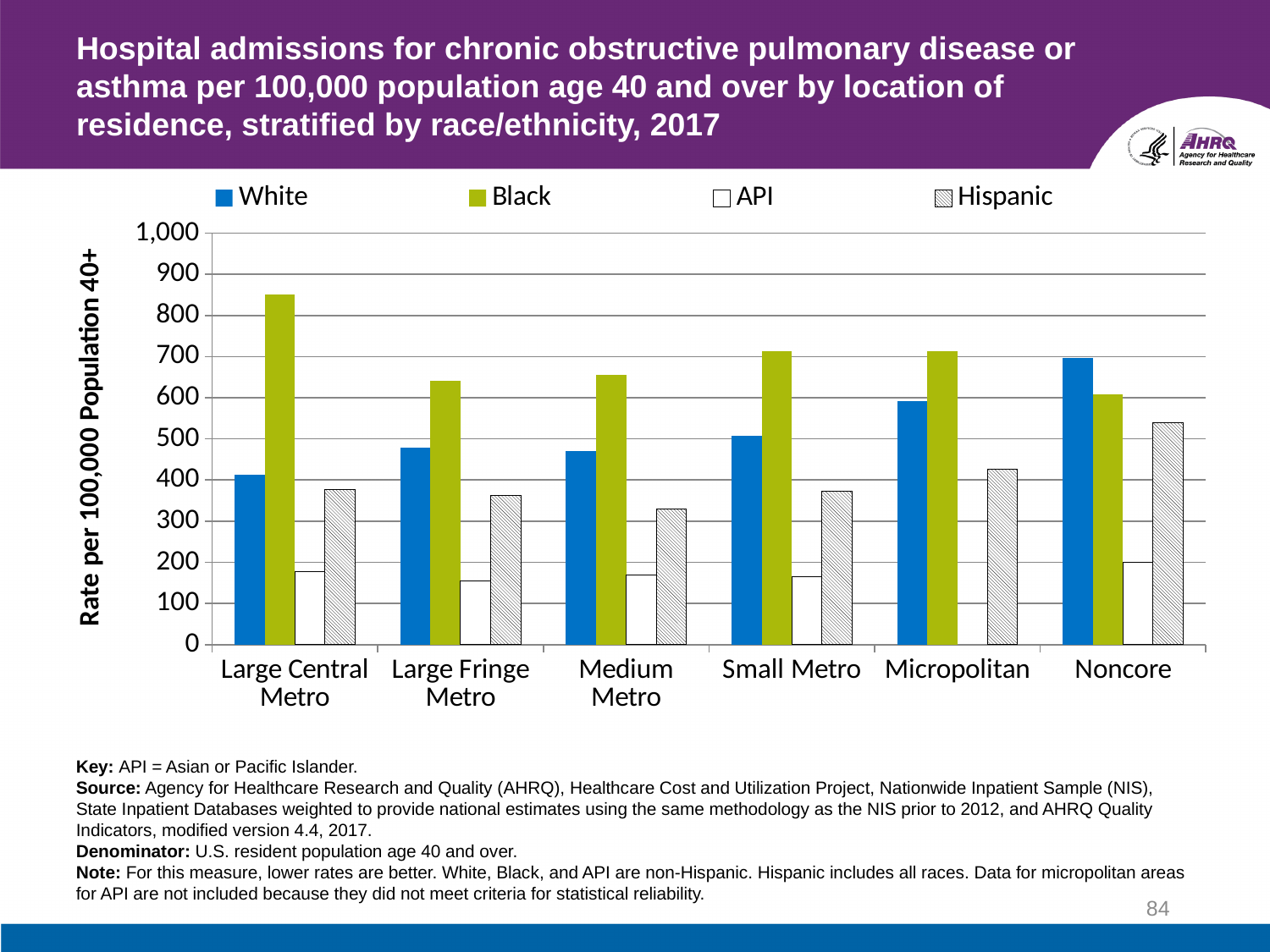
What kind of chart is shown on the slide? Bar chart Is the Hispanic rate for Noncore greater or less than 500? greater Which location category has the highest Black rate? Large Central Metro How many series does the legend list? 4 Which race/ethnicity group has the lowest rate in Small Metro? API How many location-of-residence categories are shown on the x axis? 6 Is the API rate for Large Central Metro greater or less than 200? less Which location category has no API bar? Micropolitan Which is larger, the Hispanic rate for Micropolitan or the Hispanic rate for Small Metro? Micropolitan Is the Black rate for Large Central Metro greater or less than 800? greater In the Noncore category, which is larger, the White rate or the Black rate? White